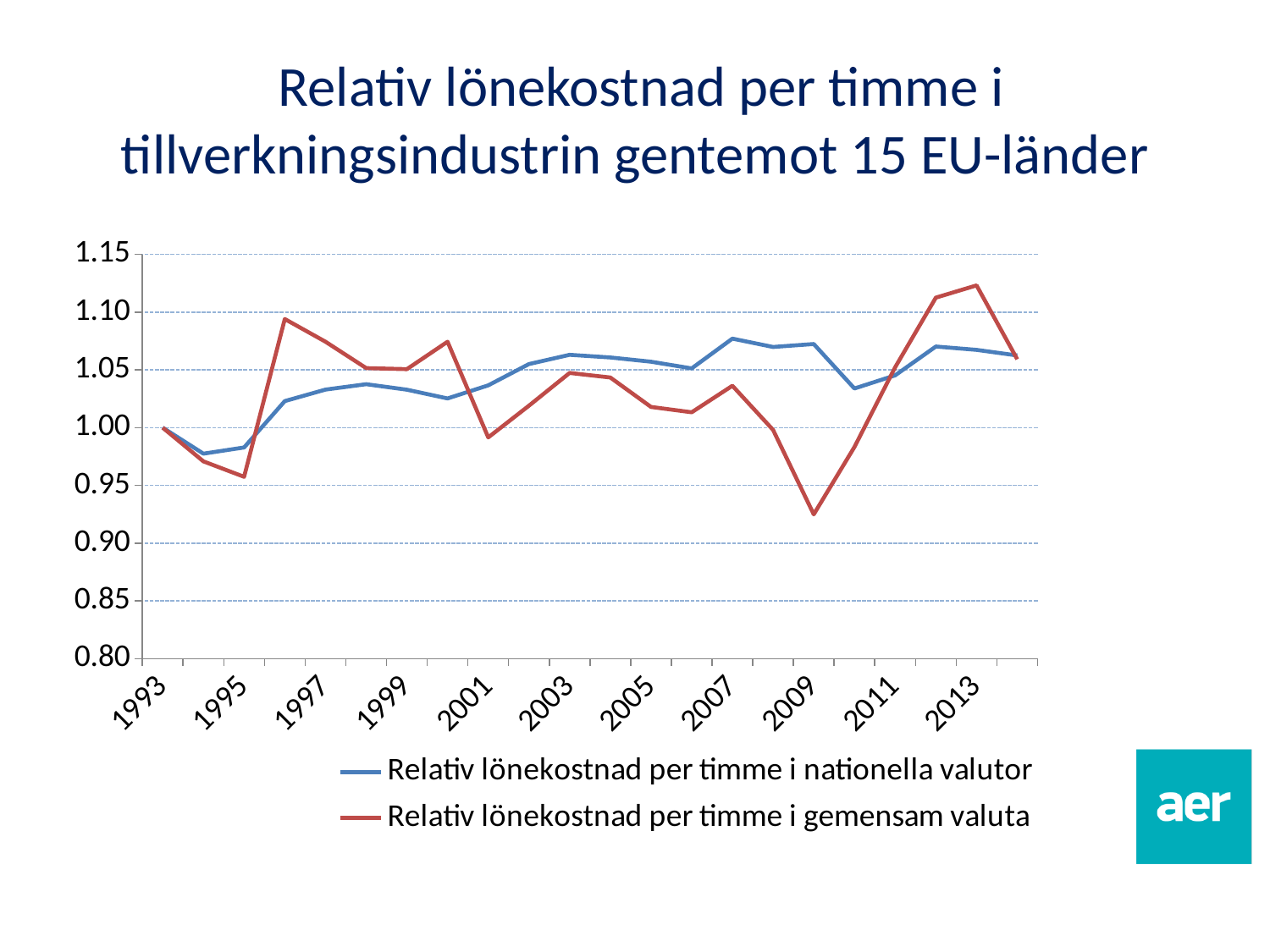
Does the value for 'Relativ lönekostnad per timme i gemensam valuta' rise or fall from 2009 to 2013? rise Which series is drawn in red? Relativ lönekostnad per timme i gemensam valuta In which year is the value for 'Relativ lönekostnad per timme i gemensam valuta' highest? 2013 In which year is the value for 'Relativ lönekostnad per timme i gemensam valuta' lowest? 2009 What is the title of the chart? Relativ lönekostnad per timme i tillverkningsindustrin gentemot 15 EU-länder How many series does the legend list? 2 Is the value for 'Relativ lönekostnad per timme i gemensam valuta' in 2009 greater or less than 0.95? less Is the value for 'Relativ lönekostnad per timme i gemensam valuta' in 2013 greater or less than 1.10? greater What is the value of both series in 1993? 1.00 In 2009, which series has the higher value? Relativ lönekostnad per timme i nationella valutor What kind of chart is shown on the slide? line chart Is the value for 'Relativ lönekostnad per timme i nationella valutor' in 2010 greater or less than 1.05? less